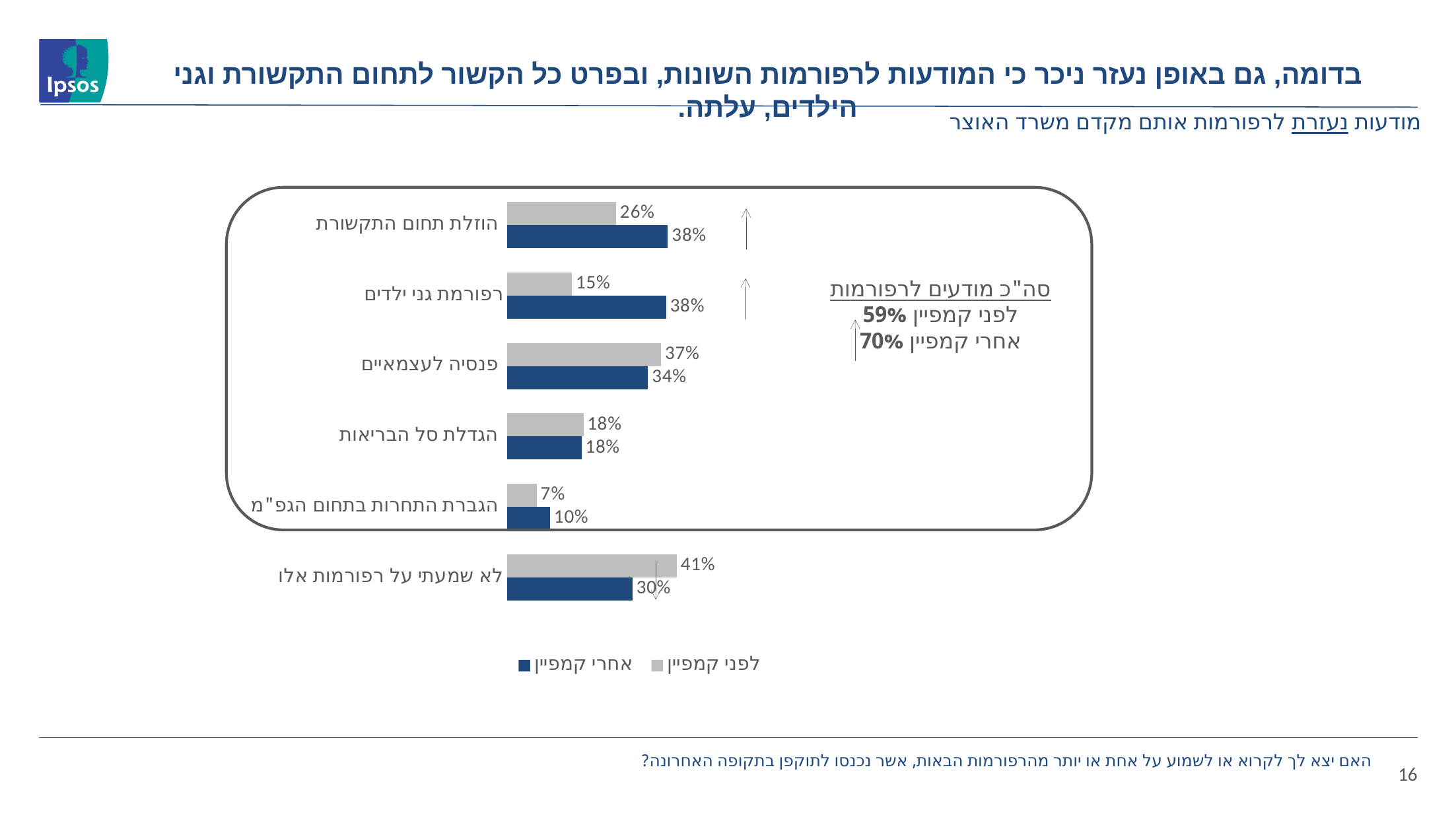
How many series does the legend list? 2 What kind of chart is shown on the slide? Bar chart Which category has the lowest value in the "אחרי קמפיין" series? הגברת התחרות בתחום הגפ"מ What is the value for "פנסיה לעצמאיים" in the "לפני קמפיין" series? 37% How many categories are shown in the chart? 6 What is the difference between the "לפני קמפיין" and "אחרי קמפיין" values for "לא שמעתי על רפורמות אלו"? 11% Which category has the highest value in the "לפני קמפיין" series? לא שמעתי על רפורמות אלו What is the value for "רפורמת גני ילדים" in the "לפני קמפיין" series? 15% What is the value for "הוזלת תחום התקשורת" in the "אחרי קמפיין" series? 38% What is the value for "הגברת התחרות בתחום הגפ"מ" in the "אחרי קמפיין" series? 10% What is the difference between the "אחרי קמפיין" and "לפני קמפיין" values for "רפורמת גני ילדים"? 23% For "פנסיה לעצמאיים", which is larger: the "לפני קמפיין" value or the "אחרי קמפיין" value? לפני קמפיין